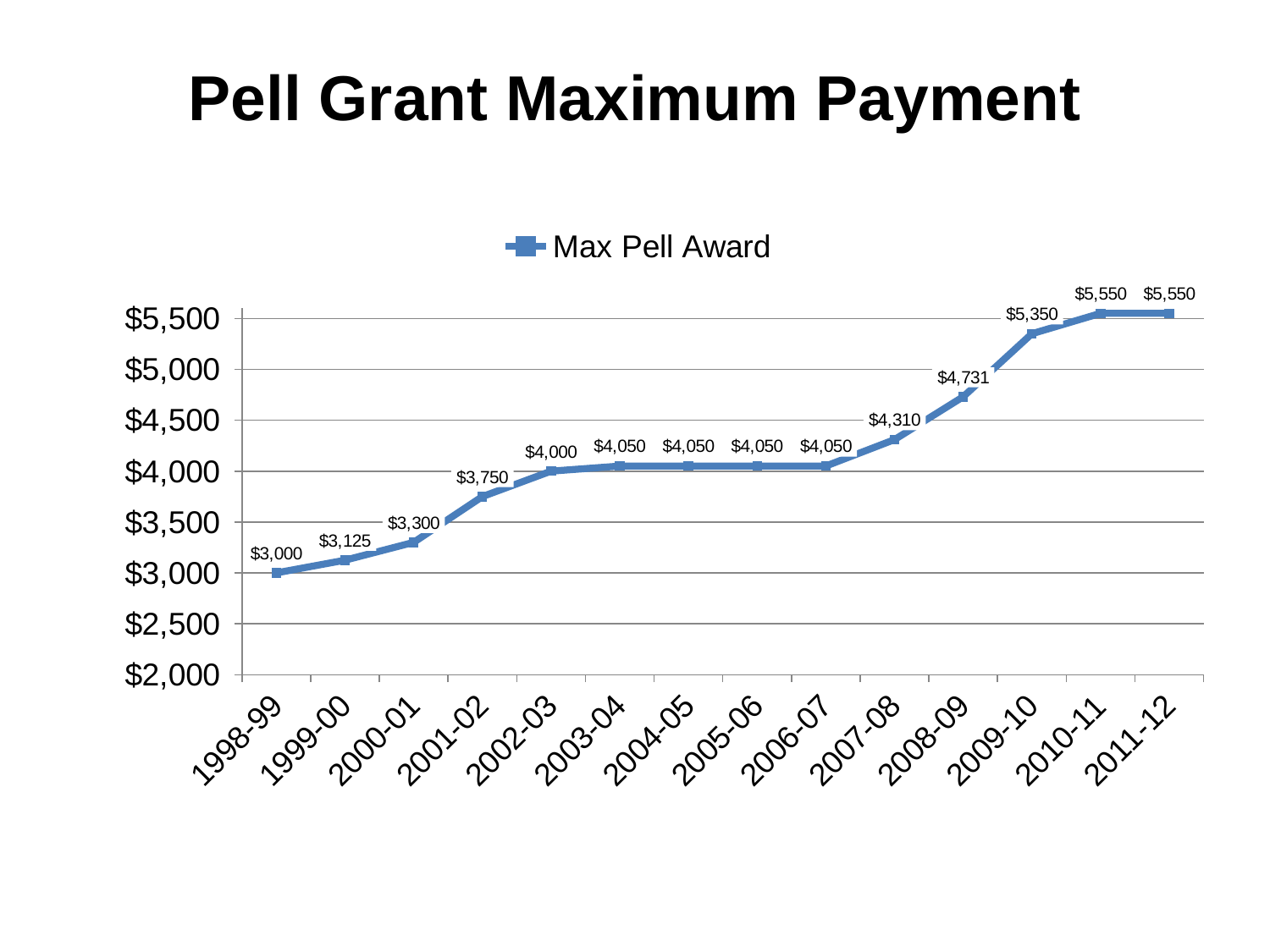
Which year has the lowest Max Pell Award? 1998-99 How many academic years are plotted on the chart? 14 What kind of chart is shown on the slide? line chart What is the Max Pell Award for 1998-99? $3,000 What is the Max Pell Award for 2002-03? $4,000 What is the Max Pell Award for 2008-09? $4,731 What is the difference between the Max Pell Award in 2011-12 and in 1998-99? $2,550 What is the highest Max Pell Award value shown on the chart? $5,550 Which is larger, the Max Pell Award in 2001-02 or in 2007-08? 2007-08 What is the difference between the Max Pell Award in 2009-10 and in 2008-09? $619 Is the Max Pell Award for 2000-01 greater or less than $3,500? less Does the Max Pell Award generally rise or fall from 1998-99 to 2011-12? rise